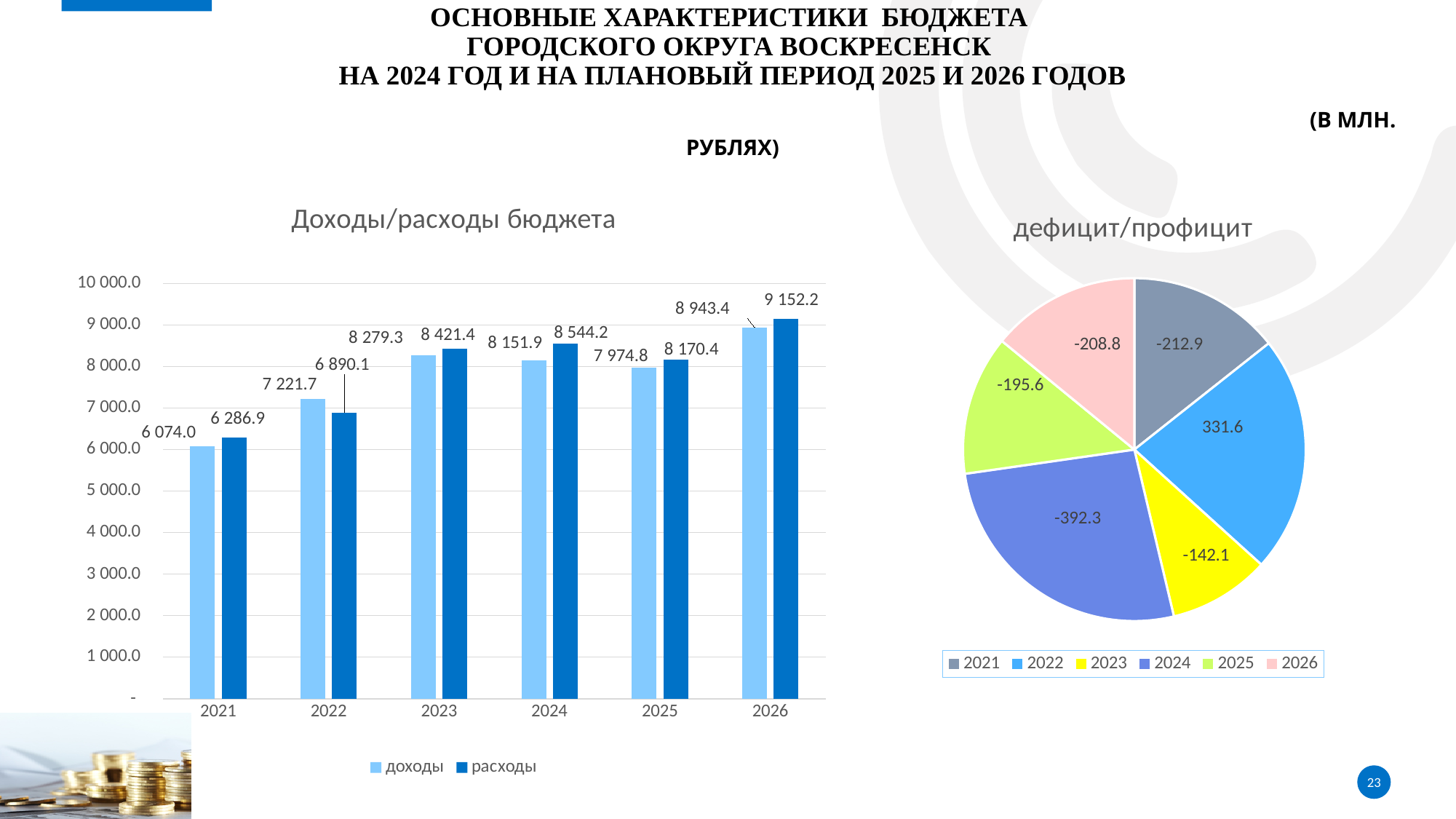
In the 'Доходы/расходы бюджета' chart, what is the difference between расходы and доходы in 2024? 392.3 In the 'Доходы/расходы бюджета' chart, which year has the highest расходы? 2026 In the 'дефицит/профицит' chart, which year is the only one with a positive value? 2022 In the 'Доходы/расходы бюджета' chart, what is the value of доходы for 2021? 6 074.0 In the 'Доходы/расходы бюджета' chart, which year has the lowest доходы? 2021 What kind of chart is 'дефицит/профицит'? pie chart In the 'дефицит/профицит' chart, how many slices does the pie have? 6 In the 'Доходы/расходы бюджета' chart, how many years are shown on the x axis? 6 In the 'Доходы/расходы бюджета' chart, what is the value of расходы for 2026? 9 152.2 In the 'Доходы/расходы бюджета' chart, which is larger in 2022: доходы or расходы? доходы In the 'Доходы/расходы бюджета' chart, how many series does the legend list? 2 In the 'дефицит/профицит' chart, what is the value for 2024? -392.3